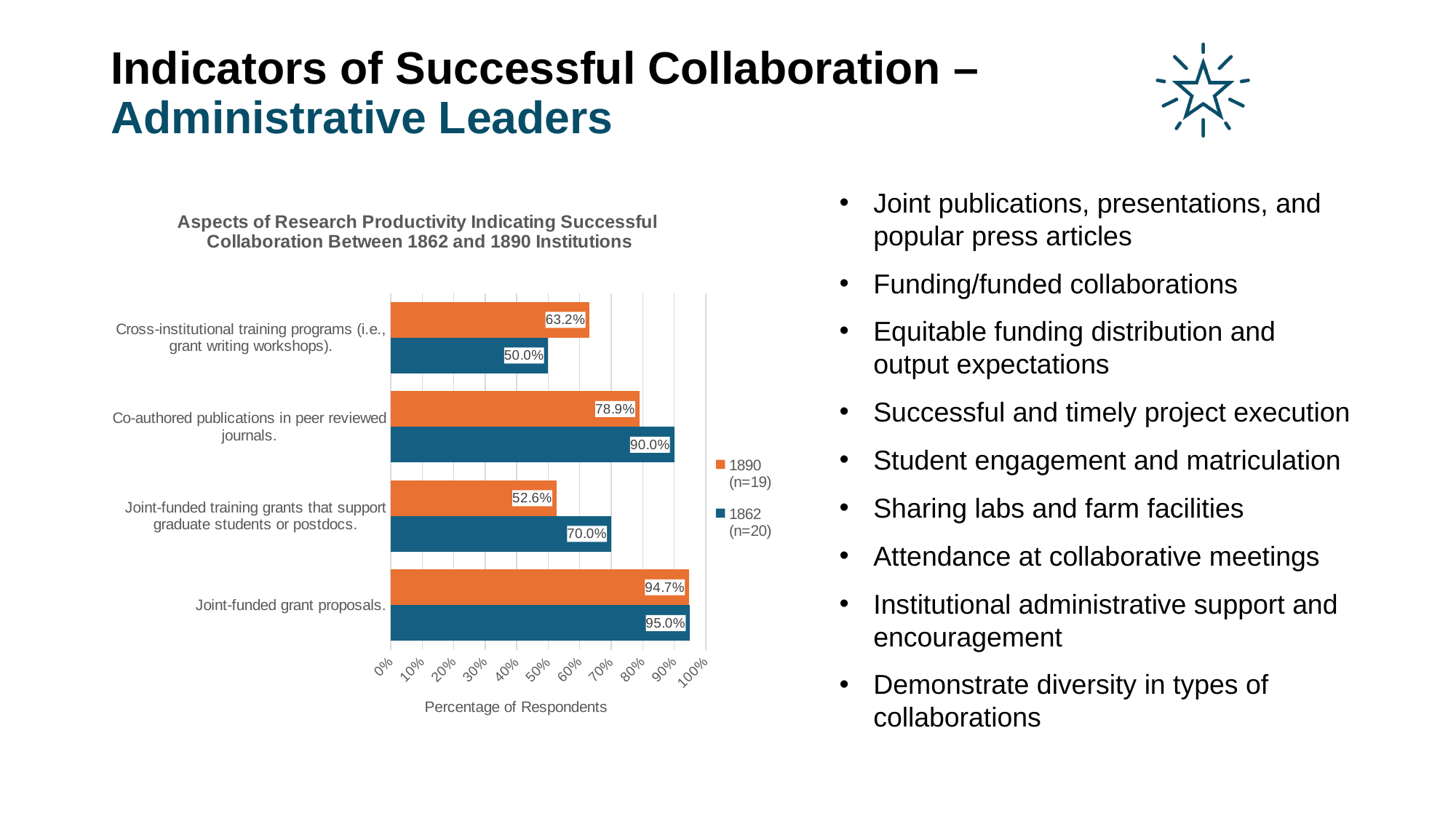
What is the difference between the 1862 (n=20) and 1890 (n=19) values for Co-authored publications in peer reviewed journals? 11.1% What is the value for 1862 (n=20) for Cross-institutional training programs (i.e., grant writing workshops)? 50.0% How many series does the legend list? 2 How many categories are shown on the chart? 4 What kind of chart is shown on the slide? Bar chart For Cross-institutional training programs, which series has the larger value, 1890 (n=19) or 1862 (n=20)? 1890 (n=19) What percentage of 1890 (n=19) respondents selected Joint-funded grant proposals? 94.7% What is the value for 1890 (n=19) for Joint-funded training grants that support graduate students or postdocs? 52.6% What percentage of 1862 (n=20) respondents selected Co-authored publications in peer reviewed journals? 90.0% What is the label of the x axis of the chart? Percentage of Respondents Which category has the lowest value for the 1890 (n=19) series? Joint-funded training grants that support graduate students or postdocs. Which category has the highest value for the 1862 (n=20) series? Joint-funded grant proposals.